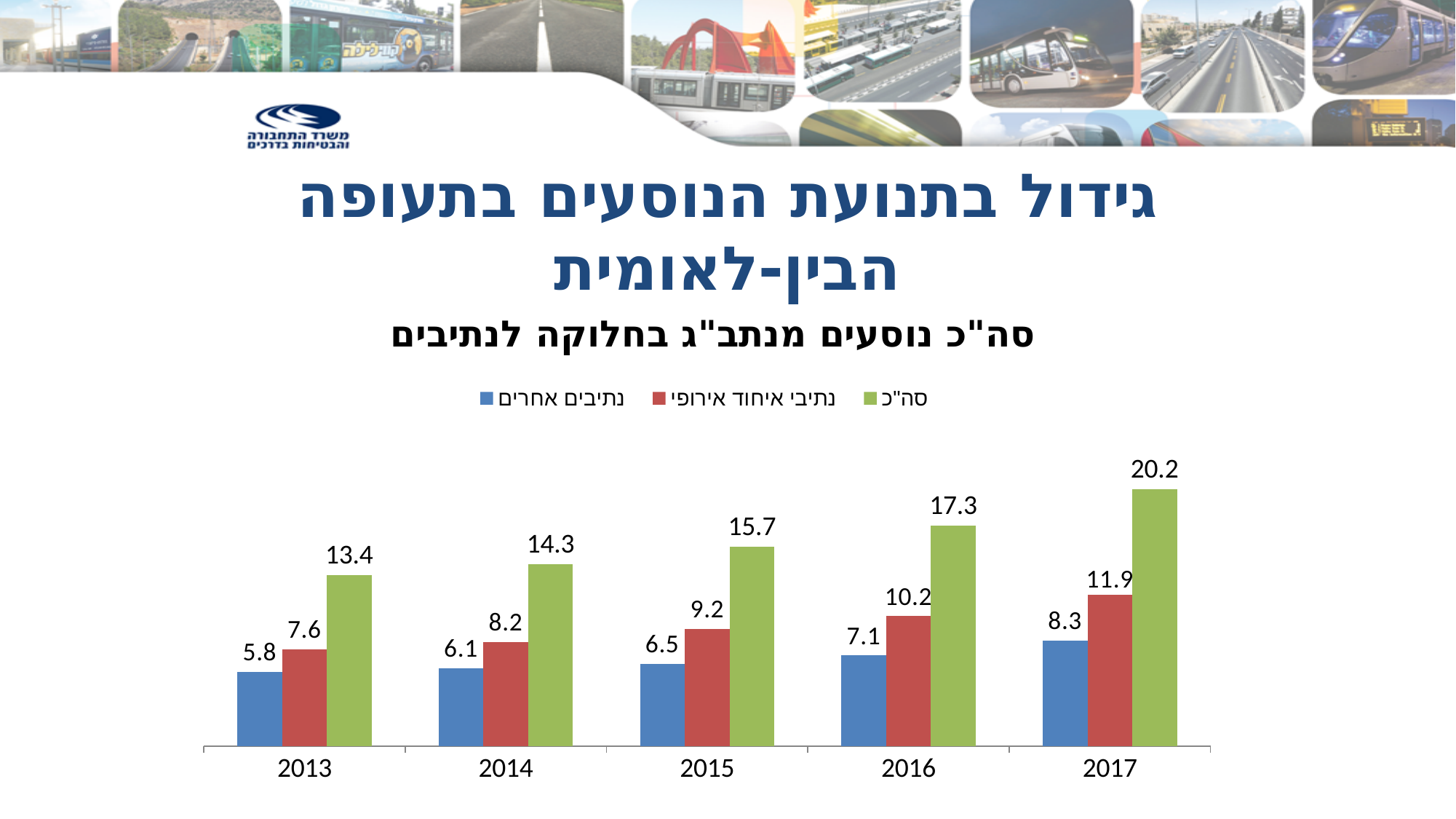
What is the value of נתיבים אחרים for 2013? 5.8 Which is larger: נתיבי איחוד אירופי in 2016 or נתיבים אחרים in 2017? נתיבי איחוד אירופי in 2016 What type of chart is shown on the slide? bar chart Do the סה"כ values rise or fall from 2013 to 2017? rise How many series does the legend list? 3 In which year is the סה"כ value highest? 2017 How many years are shown on the x axis? 5 What is the value of נתיבי איחוד אירופי for 2015? 9.2 What is the difference between the סה"כ values for 2017 and 2013? 6.8 What is the value of סה"כ for 2017? 20.2 In which year is the נתיבים אחרים value lowest? 2013 Which colour represents the סה"כ series? green